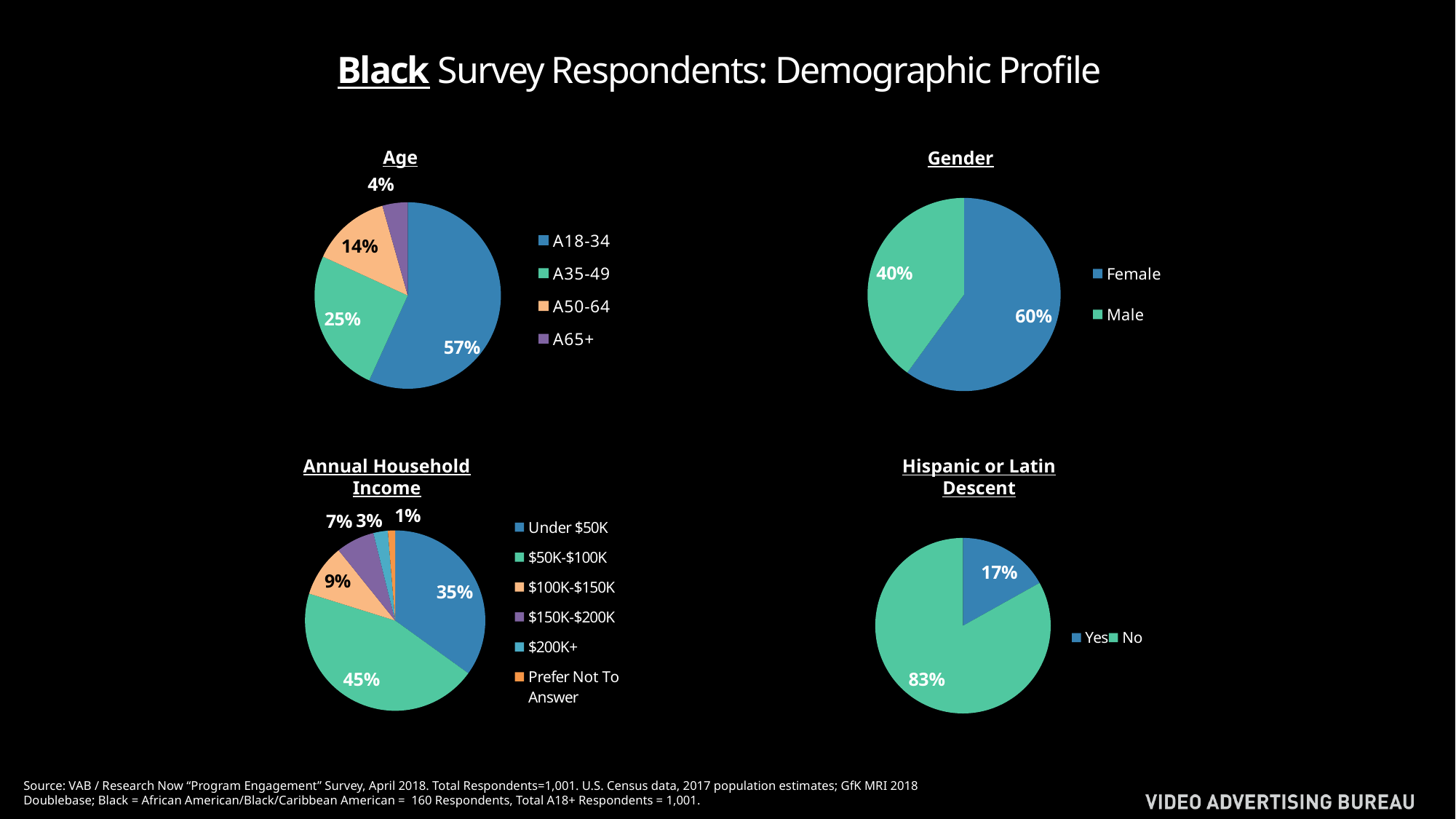
In the Hispanic or Latin Descent chart, what share of respondents answered Yes? 17% In the Age chart, what share of respondents are A18-34? 57% In the Gender chart, which is larger, Female or Male? Female In the Annual Household Income chart, what share of respondents earn $50K-$100K? 45% What kind of chart is the Hispanic or Latin Descent chart? Pie chart In the Age chart, which age group has the smallest share? A65+ In the Annual Household Income chart, which income category has the largest share? $50K-$100K How many charts are shown on the slide? 4 In the Annual Household Income chart, what is the difference between the Under $50K and $100K-$150K shares? 26% In the Annual Household Income chart, how many categories does the legend list? 6 In the Gender chart, what share of respondents are Male? 40% In the Age chart, what is the difference between the A35-49 and A50-64 shares? 11%